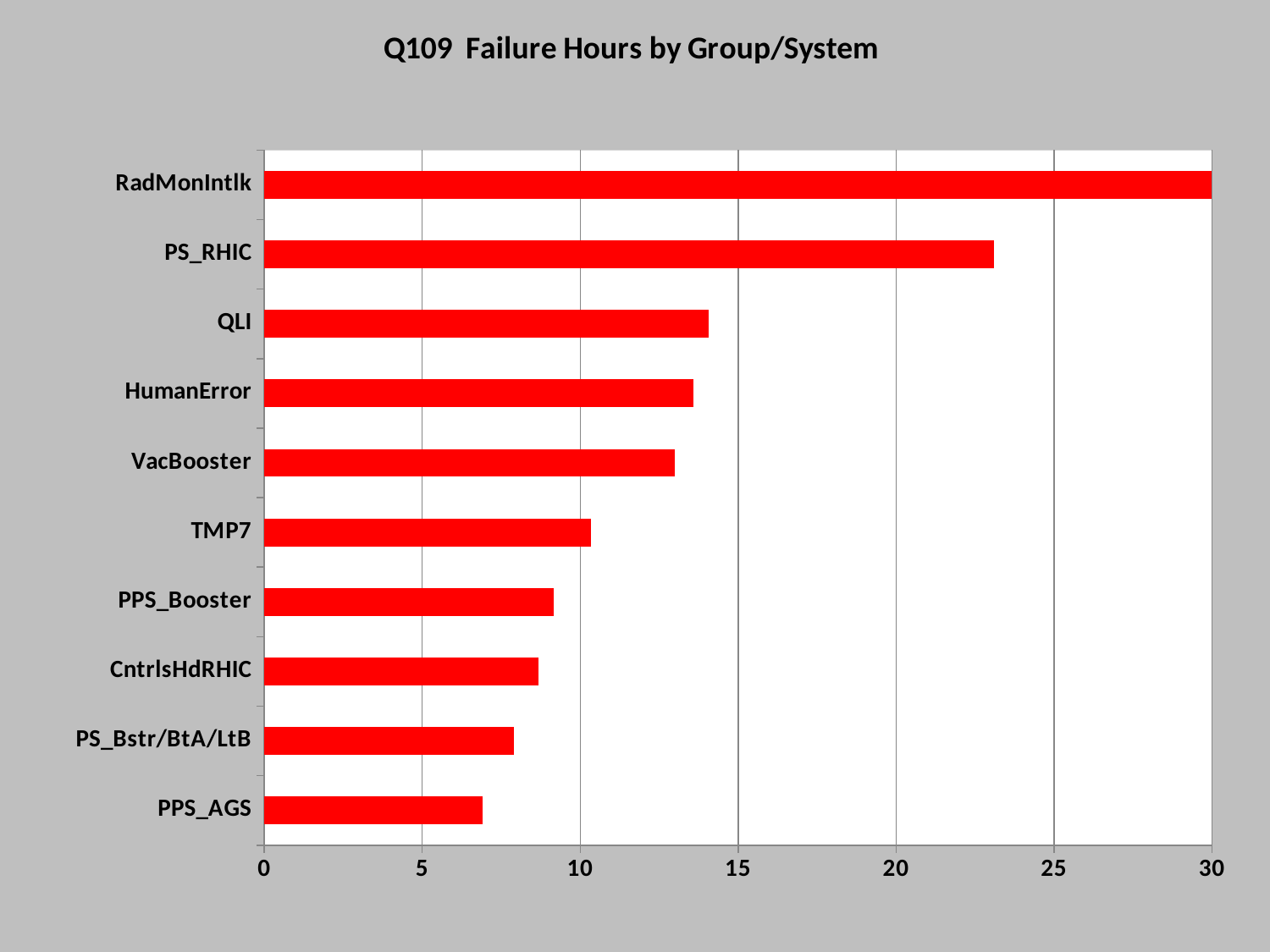
Which group/system has the highest failure hours? RadMonIntlk Which has more failure hours, TMP7 or PPS_AGS? TMP7 Is the value for PS_RHIC greater or less than 20? greater What is the title of the chart? Q109 Failure Hours by Group/System Is the value for TMP7 greater or less than 10? greater Which has more failure hours, PS_RHIC or QLI? PS_RHIC Is the value for QLI greater or less than 15? less Which group/system has the lowest failure hours? PPS_AGS What colour are the bars in the chart? red What kind of chart is shown on the slide? bar chart How many groups/systems are plotted in the chart? 10